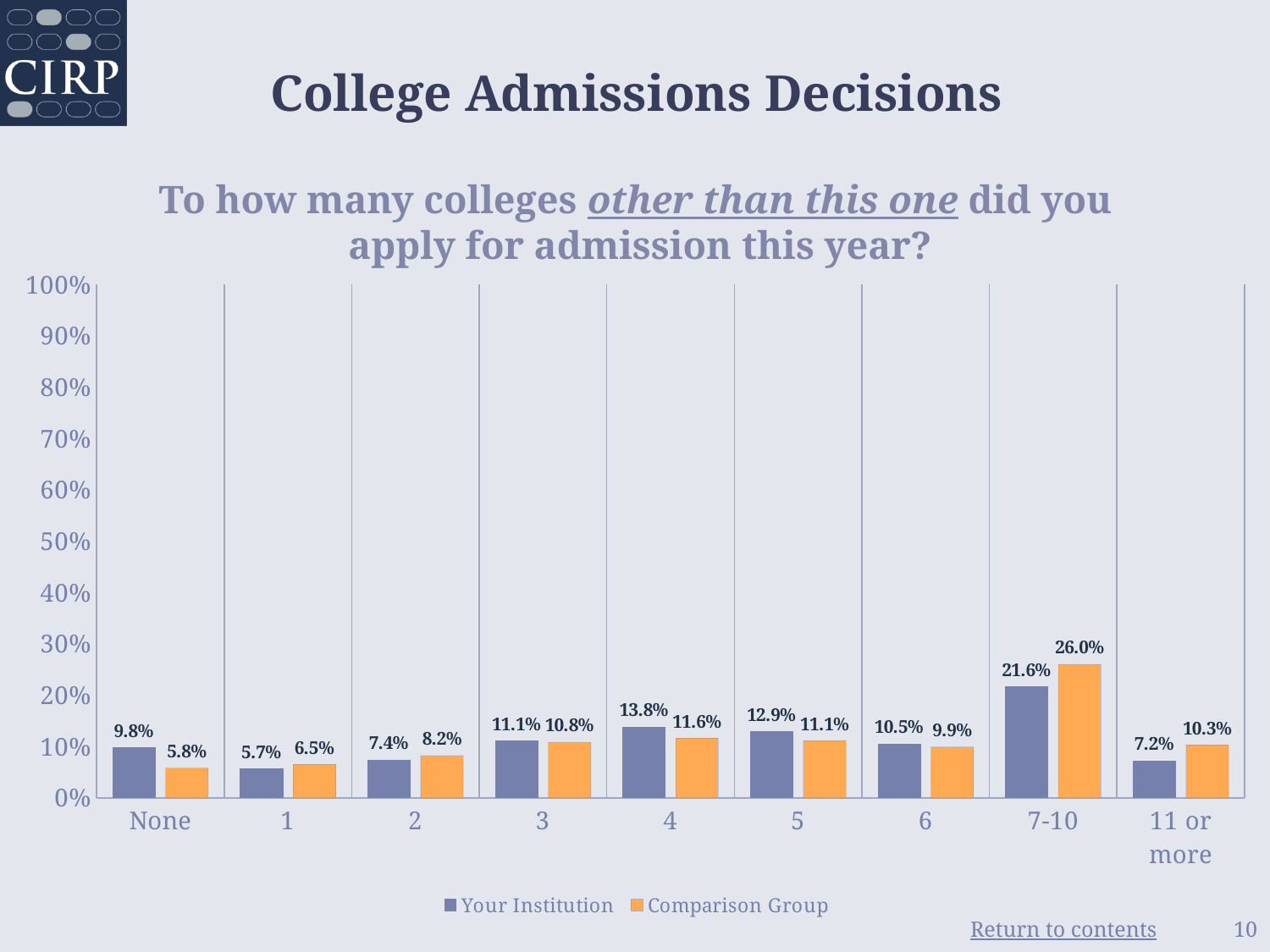
Which is larger in the None category, Your Institution or Comparison Group? Your Institution How many series does the legend list? 2 What is the value for Your Institution in the 7-10 category? 21.6% What colour are the Comparison Group bars? orange Which category has the lowest value for Your Institution? 1 What is the difference between Comparison Group and Your Institution in the 7-10 category? 4.4% Is the value for Comparison Group in the 7-10 category greater or less than 20%? greater How many categories are shown on the x axis? 9 What is the value for Your Institution in the 4 category? 13.8% What is the value for Comparison Group in the None category? 5.8% Which category has the highest value for Comparison Group? 7-10 What kind of chart is shown on the slide? bar chart